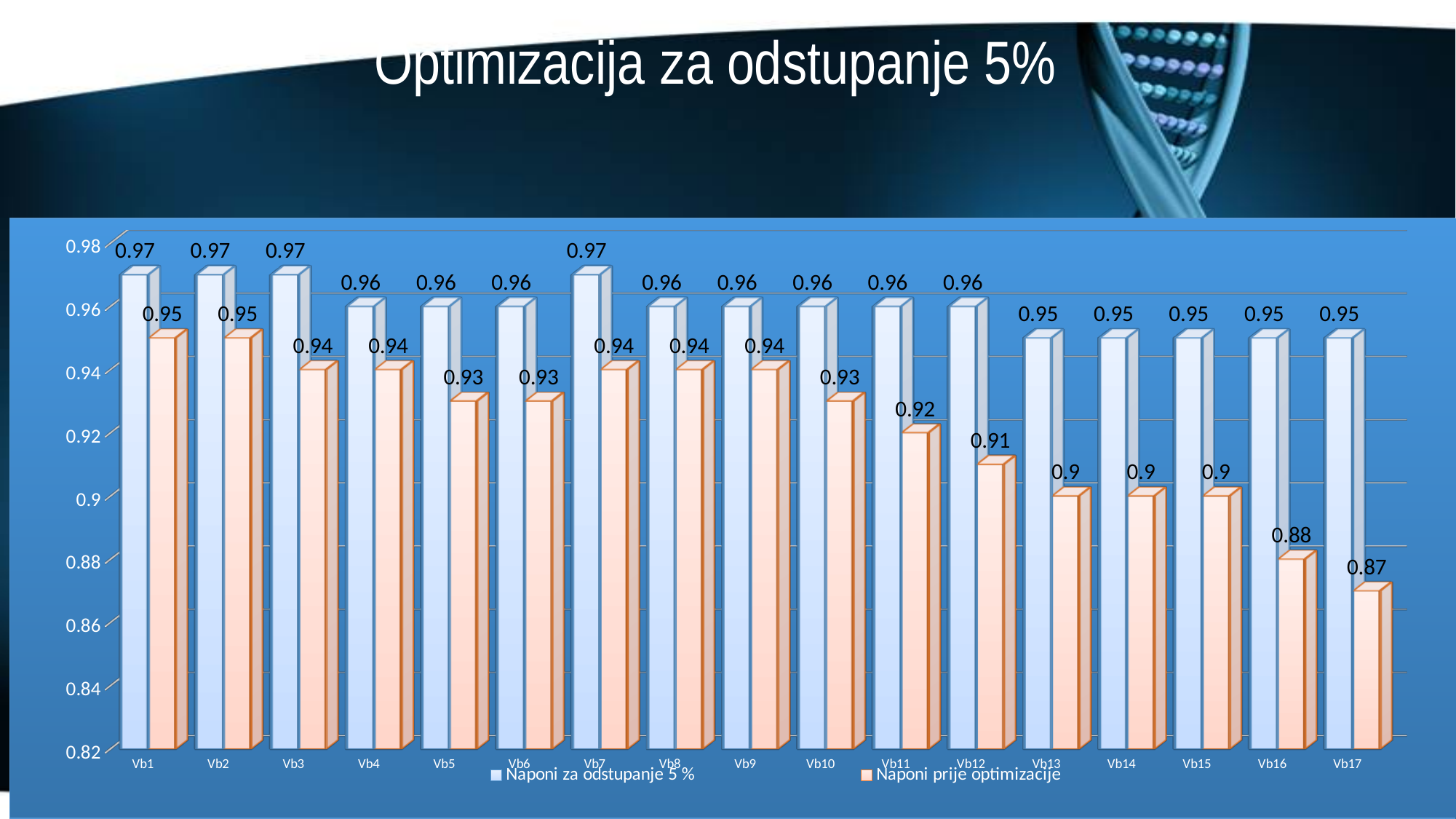
What is the value of "Naponi za odstupanje 5 %" for Vb1? 0.97 What kind of chart is shown on the slide? Bar chart Do the values of "Naponi prije optimizacije" generally rise or fall from Vb1 to Vb17? Fall What is the difference between the two series' values for Vb1? 0.02 What is the value of "Naponi prije optimizacije" for Vb12? 0.91 For Vb16, which series has the larger value, "Naponi za odstupanje 5 %" or "Naponi prije optimizacije"? Naponi za odstupanje 5 % How many series does the legend list? 2 Which category has the lowest value for "Naponi prije optimizacije"? Vb17 How many categories are shown on the x axis? 17 What is the value of "Naponi za odstupanje 5 %" for Vb15? 0.95 What is the value of "Naponi prije optimizacije" for Vb17? 0.87 What is the difference between the two series' values for Vb17? 0.08